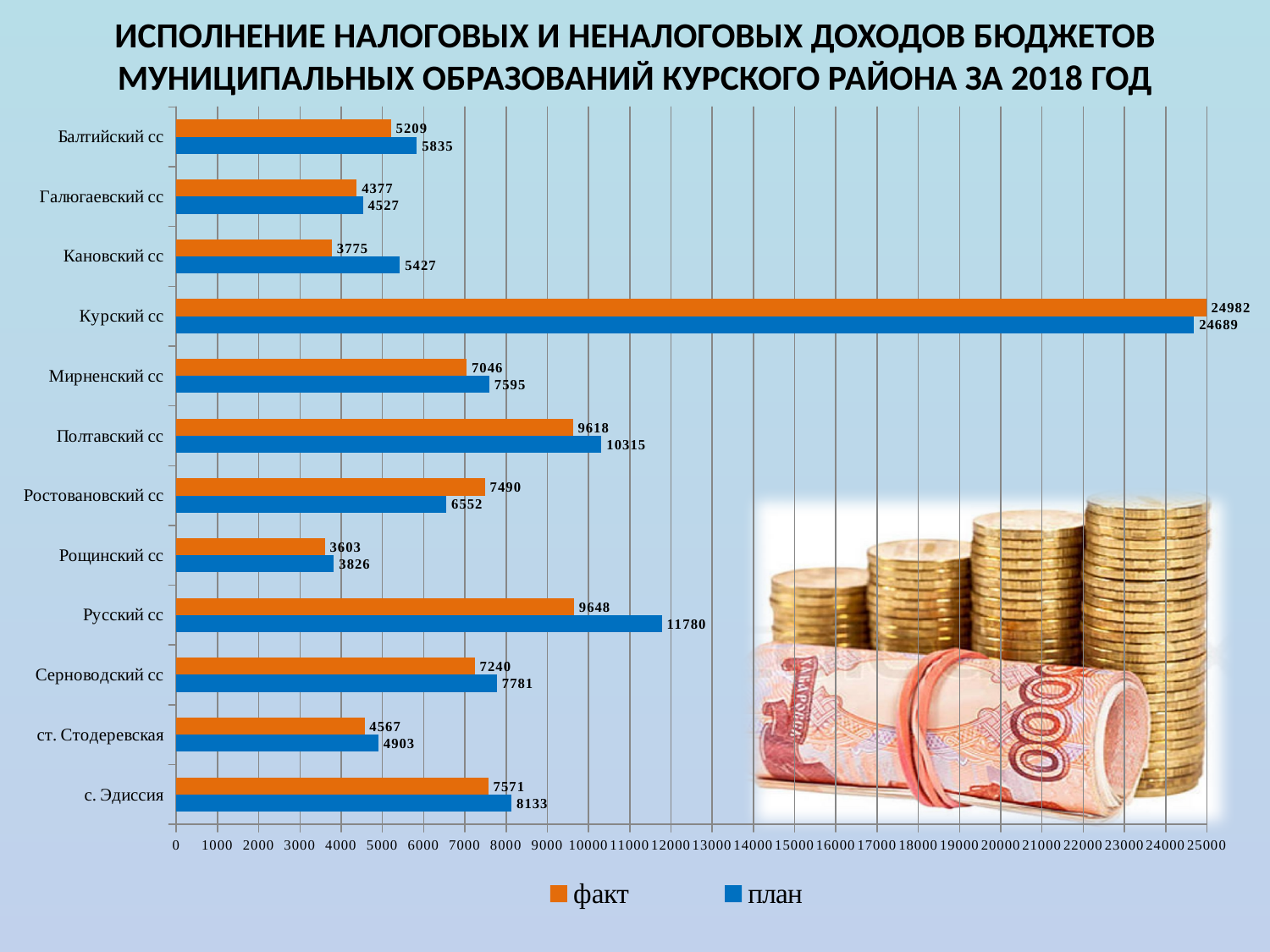
How many categories are shown on the chart? 12 What is the difference between the план and факт values for Русский сс? 2132 How many series does the legend list? 2 What is the difference between the факт and план values for Курский сс? 293 Which category has the highest факт value? Курский сс Is the план value for Полтавский сс greater or less than 10000? greater What kind of chart is shown on the slide? bar chart What is the план value for Русский сс? 11780 Which category has the lowest план value? Рощинский сс What is the план value for Кановский сс? 5427 Which is larger for Ростовановский сс, the факт value or the план value? факт What is the факт value for Курский сс? 24982